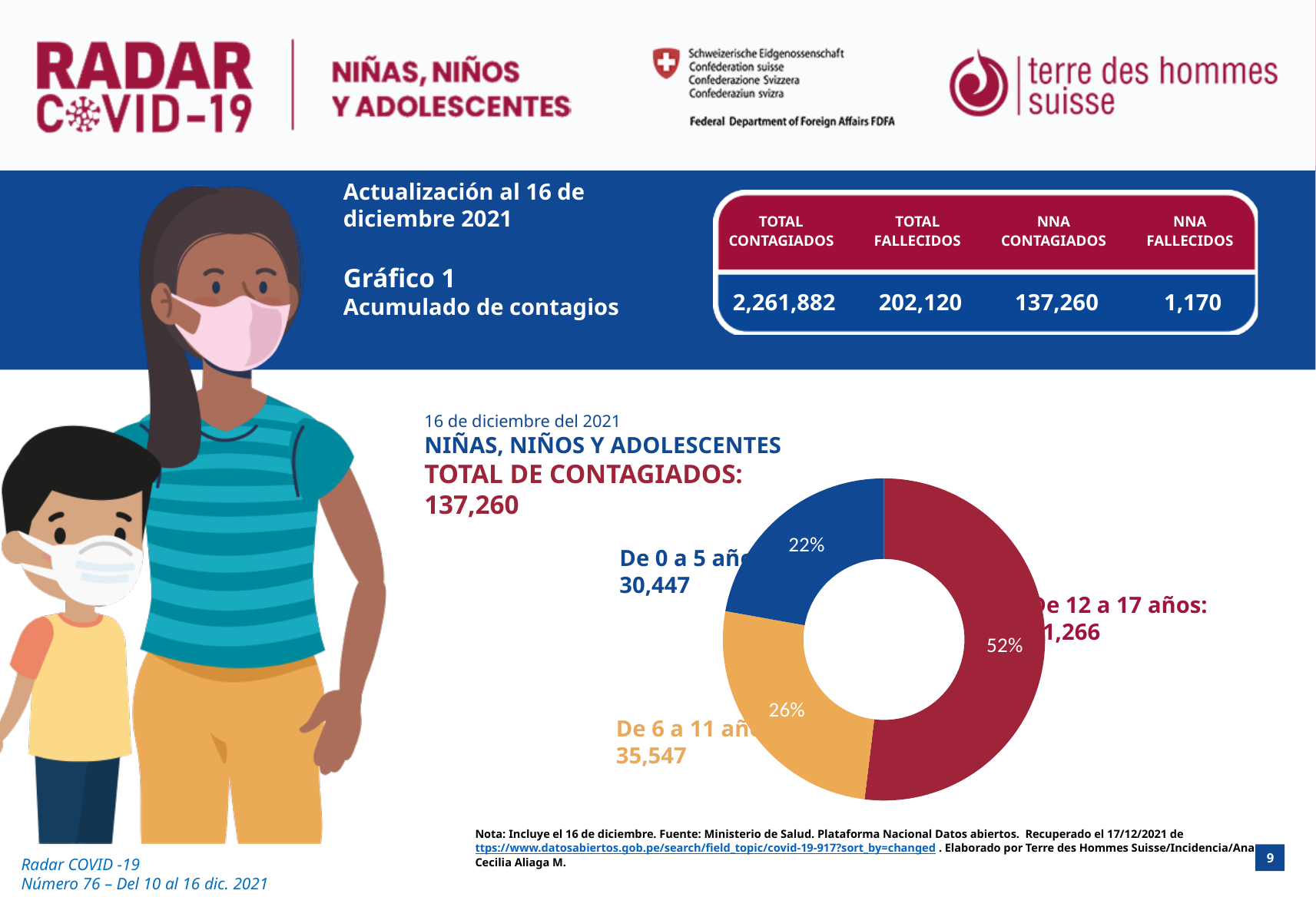
What percentage share of the donut chart does the group 'De 6 a 11 años' have? 26% What total number of contagiados among niñas, niños y adolescentes is stated next to the donut chart? 137,260 What percentage share of the donut chart does the group 'De 0 a 5 años' have? 22% How many age groups are shown in the donut chart? 3 What is the number of contagiados for the group 'De 0 a 5 años'? 30,447 Which group has more contagiados, 'De 6 a 11 años' or 'De 0 a 5 años'? De 6 a 11 años Which age group has the smallest share of contagiados in the donut chart? De 0 a 5 años What percentage share of the donut chart does the group 'De 12 a 17 años' have? 52% Which age group has the largest share of contagiados in the donut chart? De 12 a 17 años What is the number of contagiados for the group 'De 6 a 11 años'? 35,547 What is the difference in contagiados between the group 'De 6 a 11 años' and the group 'De 0 a 5 años'? 5,100 What kind of chart is shown on the slide? donut (pie) chart